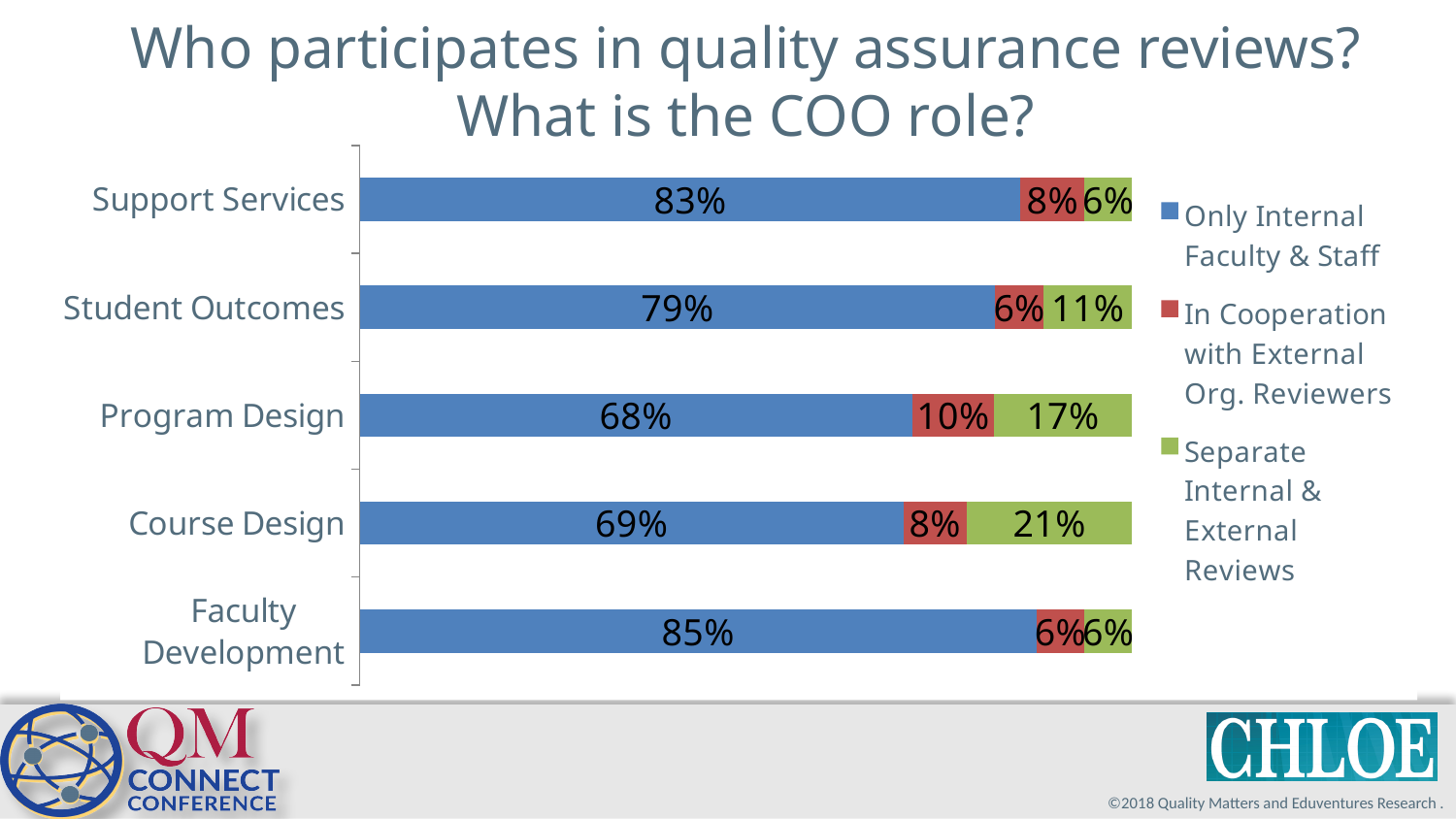
Which category has the lowest value for Only Internal Faculty & Staff? Program Design Which is larger for Separate Internal & External Reviews: Program Design or Student Outcomes? Program Design How many series does the legend list? 3 How many categories are shown on the chart? 5 What is the value for Separate Internal & External Reviews for Course Design? 21% Which category has the highest value for Only Internal Faculty & Staff? Faculty Development What is the value for In Cooperation with External Org. Reviewers for Student Outcomes? 6% Which category has the highest value for Separate Internal & External Reviews? Course Design What is the difference between the Only Internal Faculty & Staff values for Support Services and Student Outcomes? 4% What is the total of the three segments for the Course Design bar? 98% What is the value for Only Internal Faculty & Staff for Program Design? 68% What kind of chart is shown on the slide? Stacked bar chart